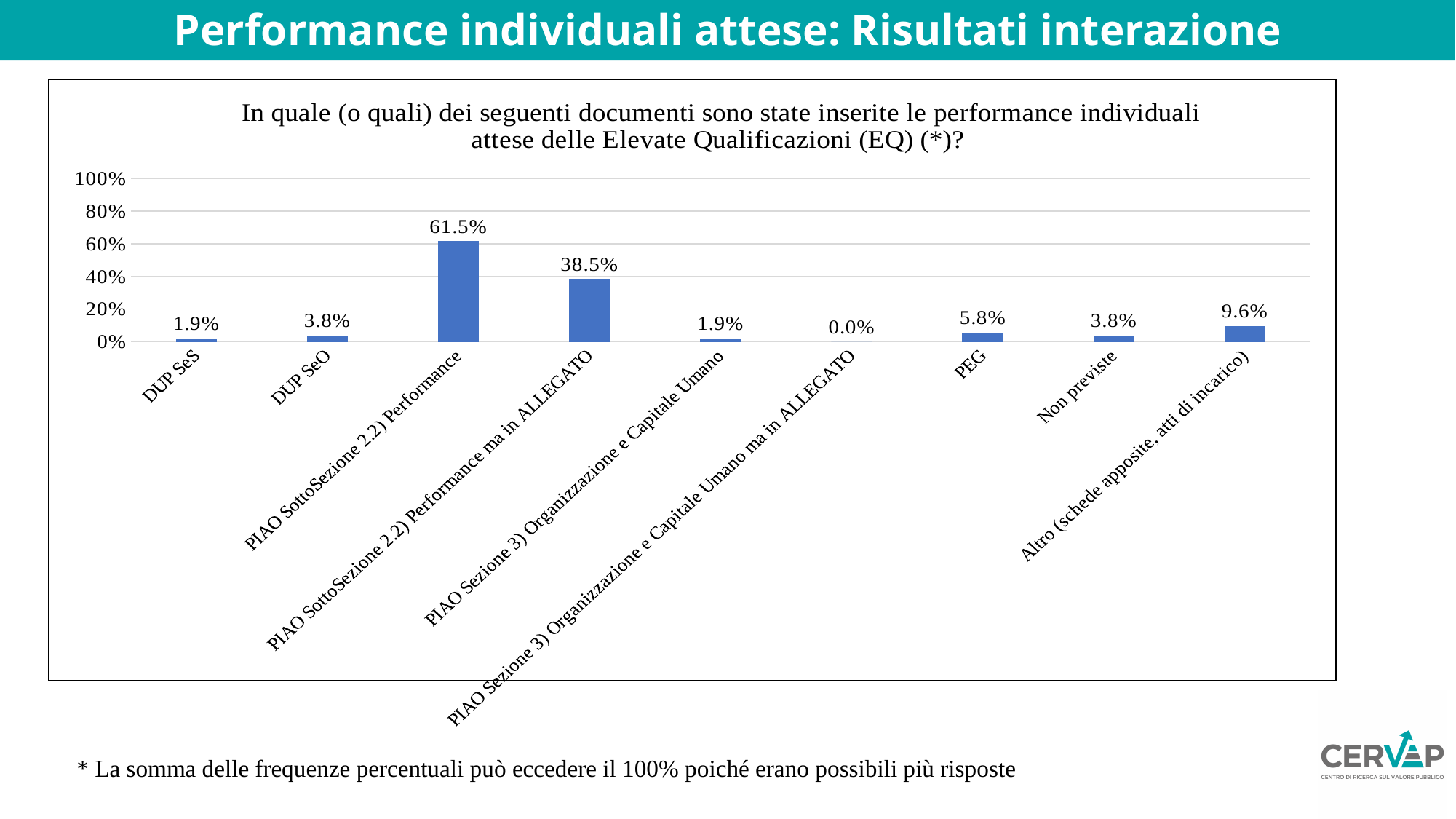
Which category has the lowest value? PIAO Sezione 3) Organizzazione e Capitale Umano ma in ALLEGATO What is the value for PEG? 5.8% Which is larger, the value for PEG or the value for Non previste? PEG What is the value for PIAO Sezione 3) Organizzazione e Capitale Umano ma in ALLEGATO? 0.0% How many categories are shown on the x axis? 9 Is the value for PIAO SottoSezione 2.2) Performance ma in ALLEGATO greater or less than 40%? less What is the difference between the values for PIAO SottoSezione 2.2) Performance and PIAO SottoSezione 2.2) Performance ma in ALLEGATO? 23.0% What is the value for DUP SeO? 3.8% Which category has the highest value? PIAO SottoSezione 2.2) Performance What is the value for Altro (schede apposite, atti di incarico)? 9.6% What kind of chart is shown on the slide? bar chart What is the value for PIAO SottoSezione 2.2) Performance? 61.5%